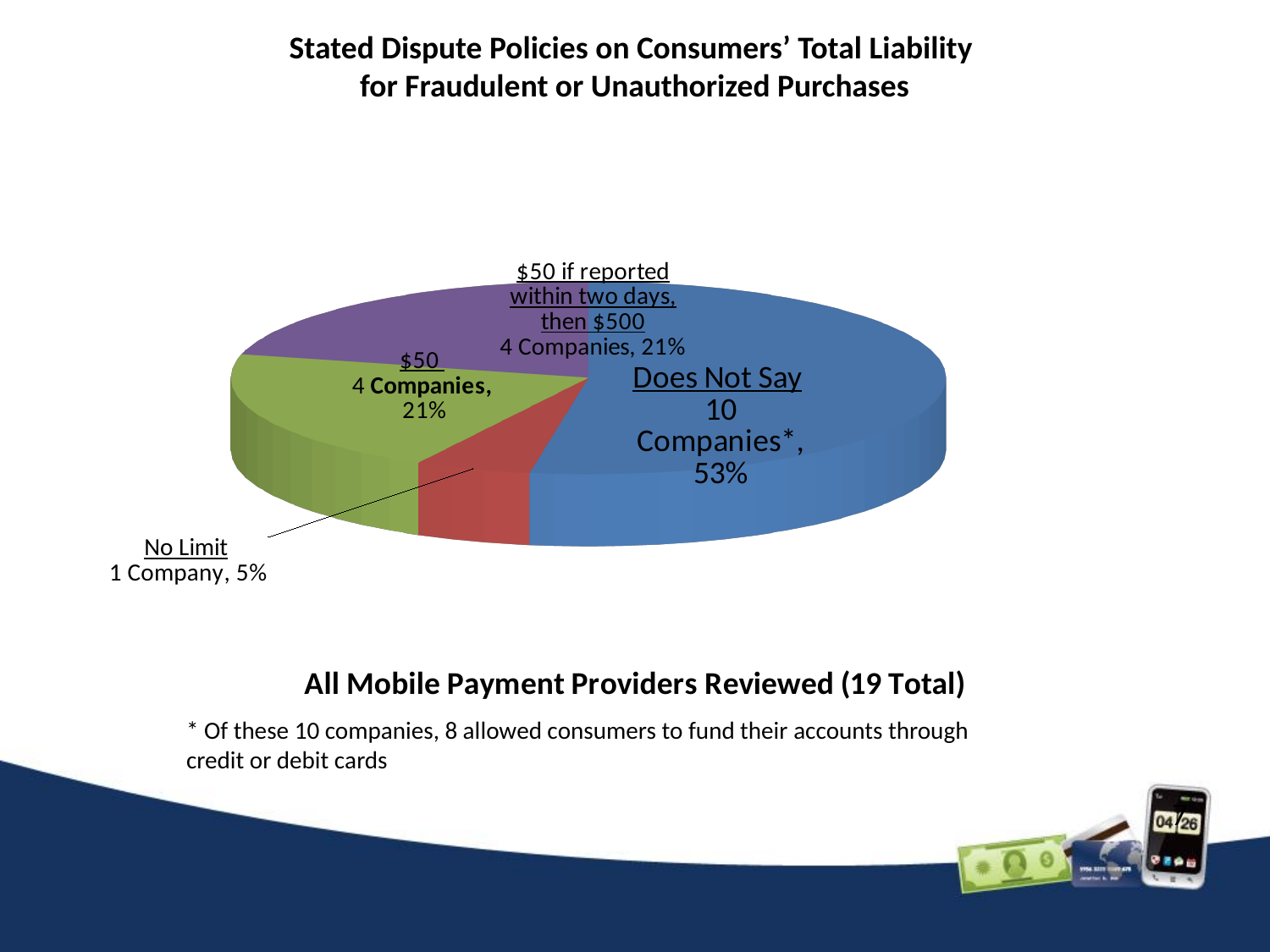
How many slices does the pie chart have? 4 What percentage of the pie is the "No Limit" slice? 5% How many more companies are in the "Does Not Say" category than in the "$50" category? 6 How many companies have a policy of "$50 if reported within two days, then $500"? 4 How many companies are in the "Does Not Say" category? 10 Which category has the smallest slice of the pie? No Limit Which category has the largest slice of the pie? Does Not Say How many companies are in the "No Limit" category? 1 What percentage of the pie is the "$50" slice? 21% What kind of chart is shown on the slide? Pie chart Which is larger, the "Does Not Say" slice or the "No Limit" slice? Does Not Say What share of the pie does the "Does Not Say" slice represent? 53%